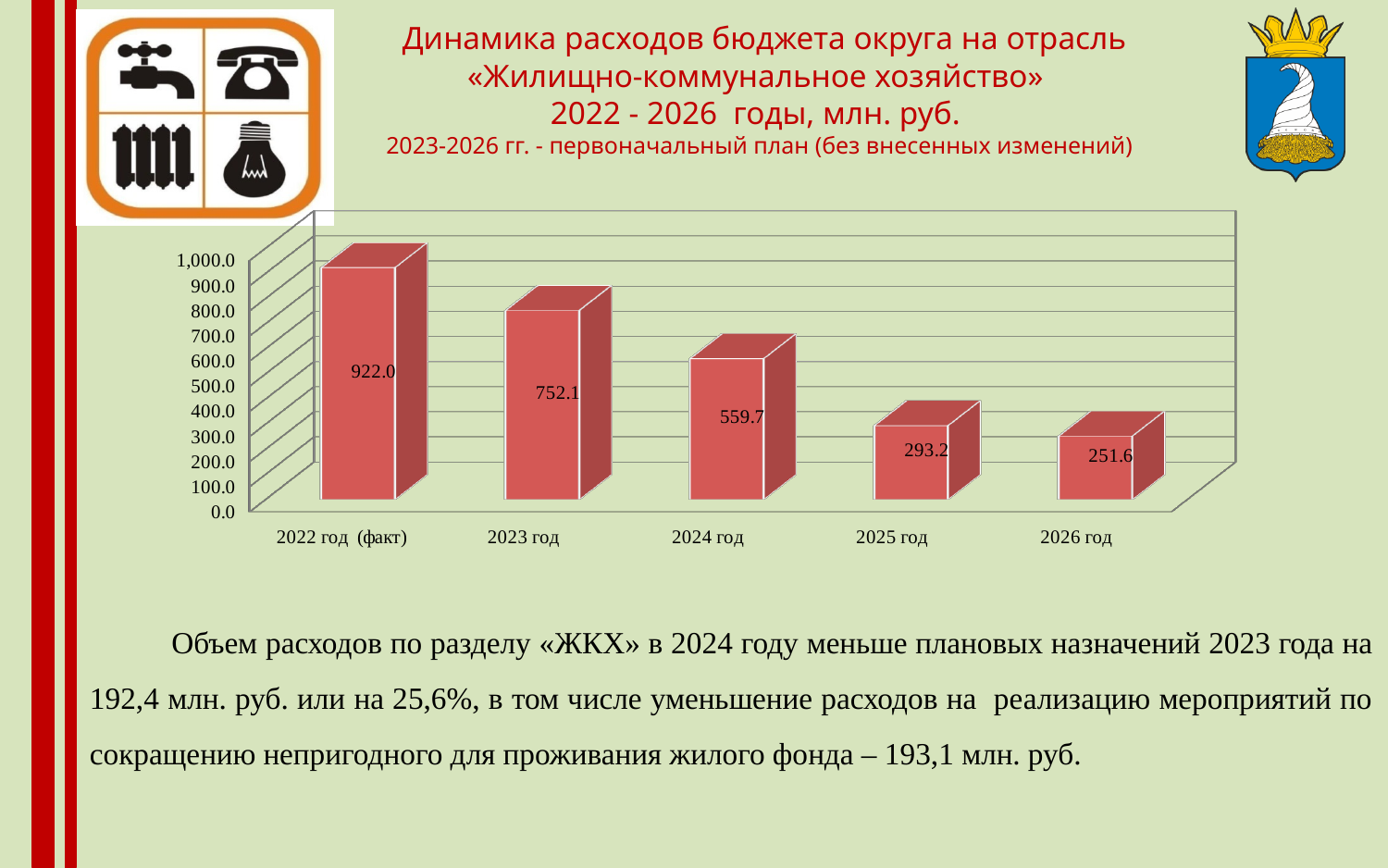
Which is larger, the value for 2023 год or the value for 2025 год? 2023 год Do the values rise or fall from 2022 to 2026? fall How many years are shown on the chart? 5 Which year has the highest value? 2022 год (факт) Is the value for 2024 год greater or less than 500.0? greater What kind of chart is shown on the slide? bar chart What is the difference between the values for 2023 год and 2024 год? 192.4 What is the value for 2022 год (факт)? 922.0 What is the value for 2024 год? 559.7 What is the value for 2026 год? 251.6 What is the difference between the values for 2025 год and 2026 год? 41.6 Which year has the lowest value? 2026 год